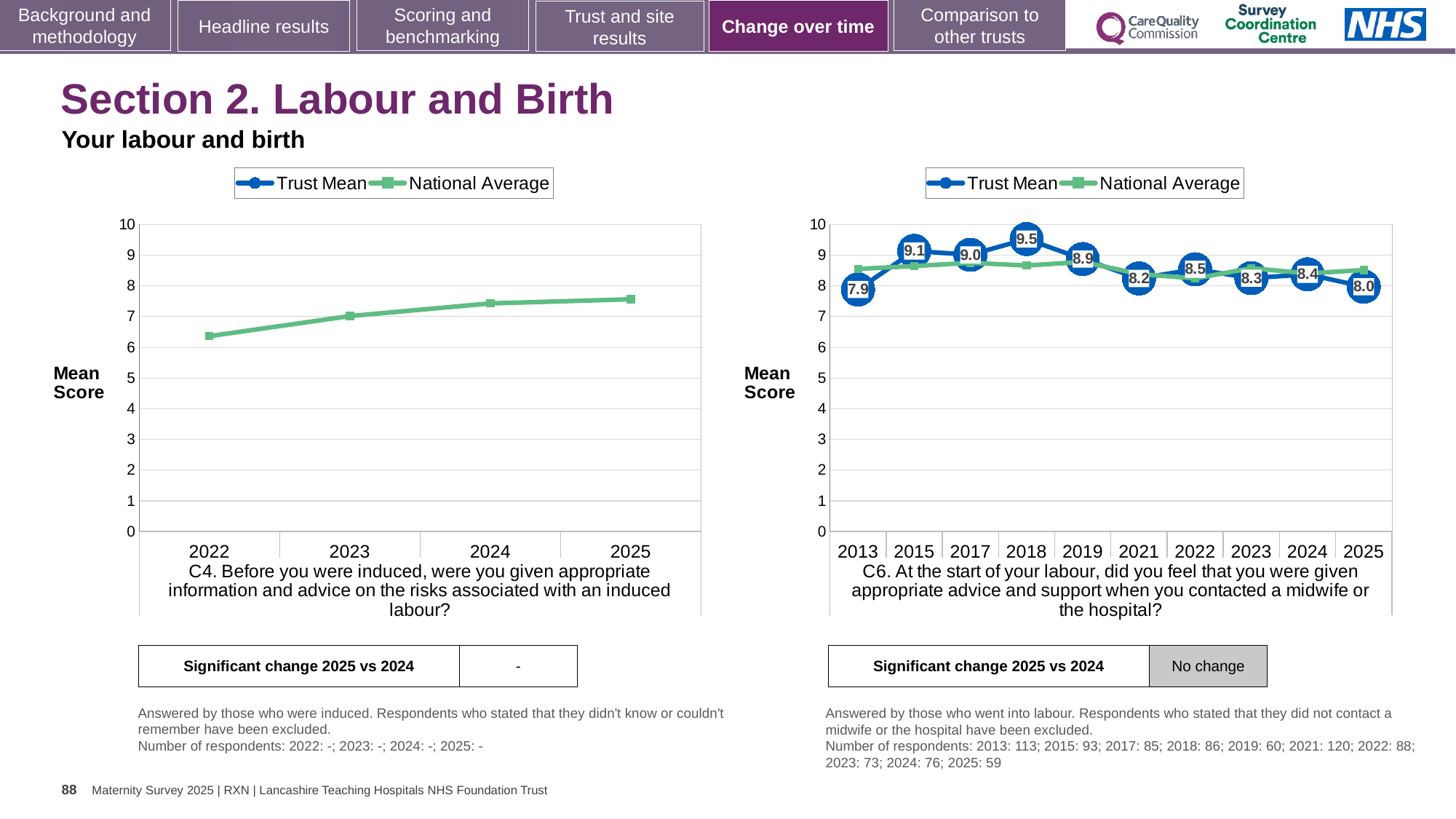
How many series does the legend of the C4 chart on the left list? 2 In the C6 chart on the right, what is the Trust Mean score for 2018? 9.5 In the C6 chart on the right, which year has the lowest Trust Mean score? 2013 In the C4 chart on the left, does the National Average rise or fall from 2022 to 2025? Rise In the C6 chart on the right, what is the difference between the Trust Mean scores for 2018 and 2025? 1.5 In the C6 chart on the right, which year has the larger Trust Mean score, 2015 or 2021? 2015 How many years are shown on the x axis of the C6 chart on the right? 10 In the C6 chart on the right, which year has the highest Trust Mean score? 2018 What kind of chart is the C4 chart on the left? Line chart In the C6 chart on the right, what is the Trust Mean score for 2013? 7.9 In the C6 chart on the right, what is the Trust Mean score for 2025? 8.0 In the C4 chart on the left, is the National Average value for 2022 greater or less than 7? less